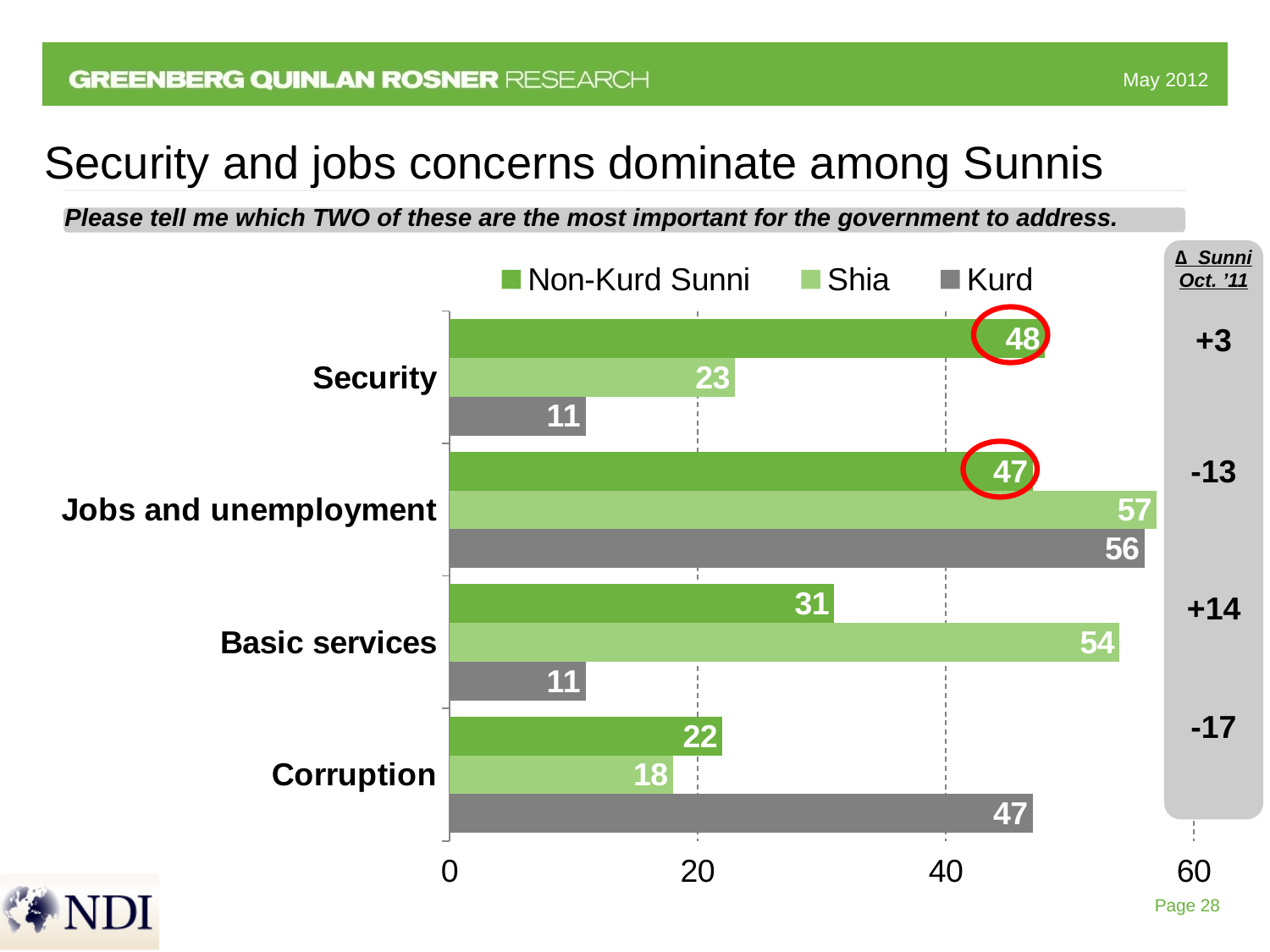
What is the Shia value for Jobs and unemployment? 57 Which category has the highest Kurd value? Jobs and unemployment What is the change for Sunnis since Oct. '11 shown for Basic services? +14 How many series does the legend list? 3 Which category has the lowest Shia value? Corruption Is the Non-Kurd Sunni value for Basic services greater or less than 40? less What is the Non-Kurd Sunni value for Security? 48 What is the difference between the Shia and Kurd values for Basic services? 43 Which is larger for Corruption: the Non-Kurd Sunni value or the Kurd value? Kurd What is the Kurd value for Corruption? 47 How many categories are shown on the chart? 4 What kind of chart is shown on the slide? bar chart